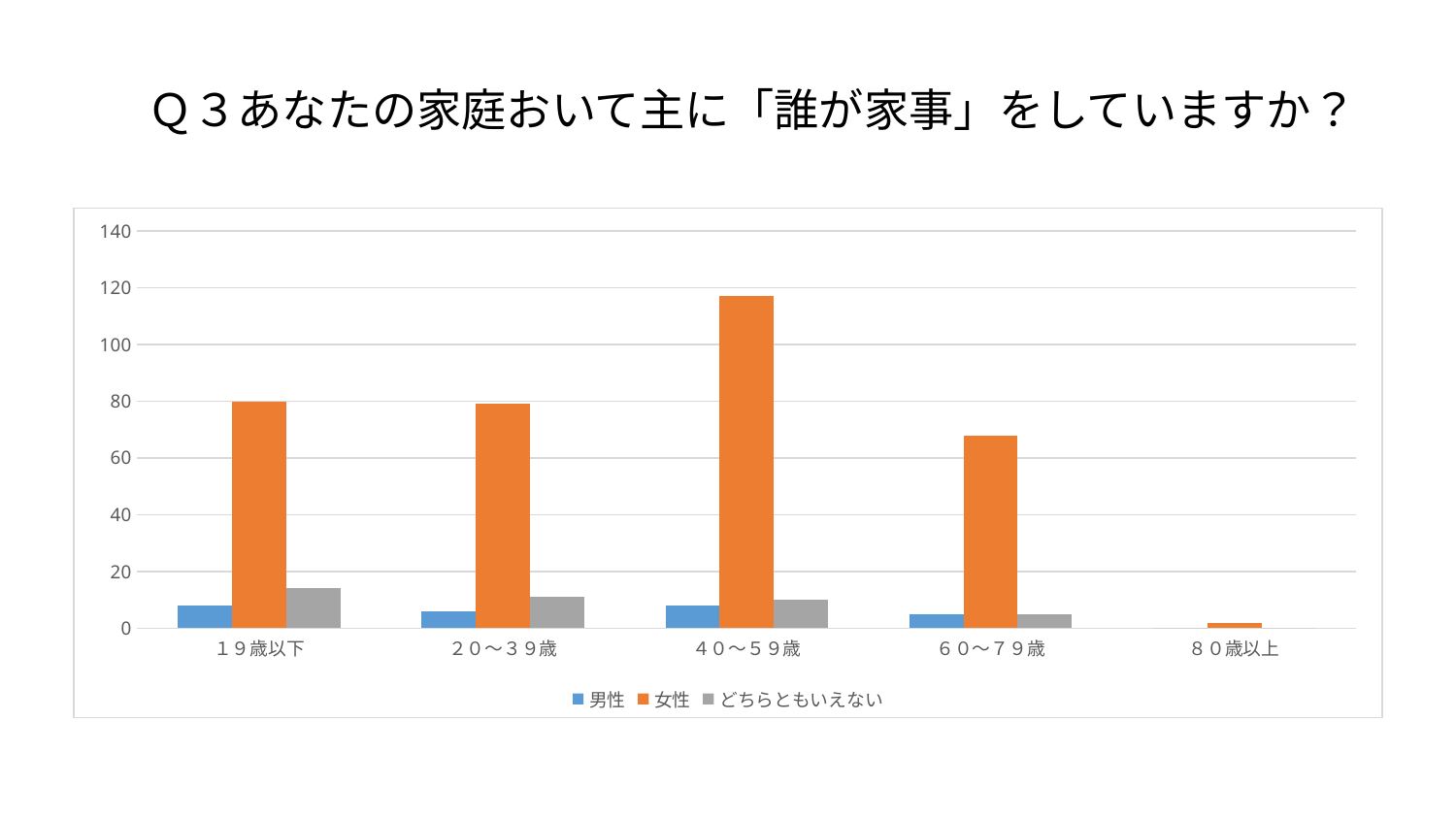
How many age categories are shown on the x axis? 5 Which age category has the highest value for 女性? 40〜59歳 Is the value for どちらともいえない in 19歳以下 greater or less than 20? less Which is larger, the 女性 value for 40〜59歳 or for 60〜79歳? 40〜59歳 How many series does the legend list? 3 Which age category has the lowest value for 女性? 80歳以上 Which age category has the highest value for どちらともいえない? 19歳以下 What kind of chart is shown on the slide? Bar chart What is the title of the slide? Q3あなたの家庭おいて主に「誰が家事」をしていますか？ In the 19歳以下 category, which is larger, the 男性 value or the どちらともいえない value? どちらともいえない Is the value for 女性 in 60〜79歳 greater or less than 80? less Is the value for 女性 in 40〜59歳 greater or less than 100? greater